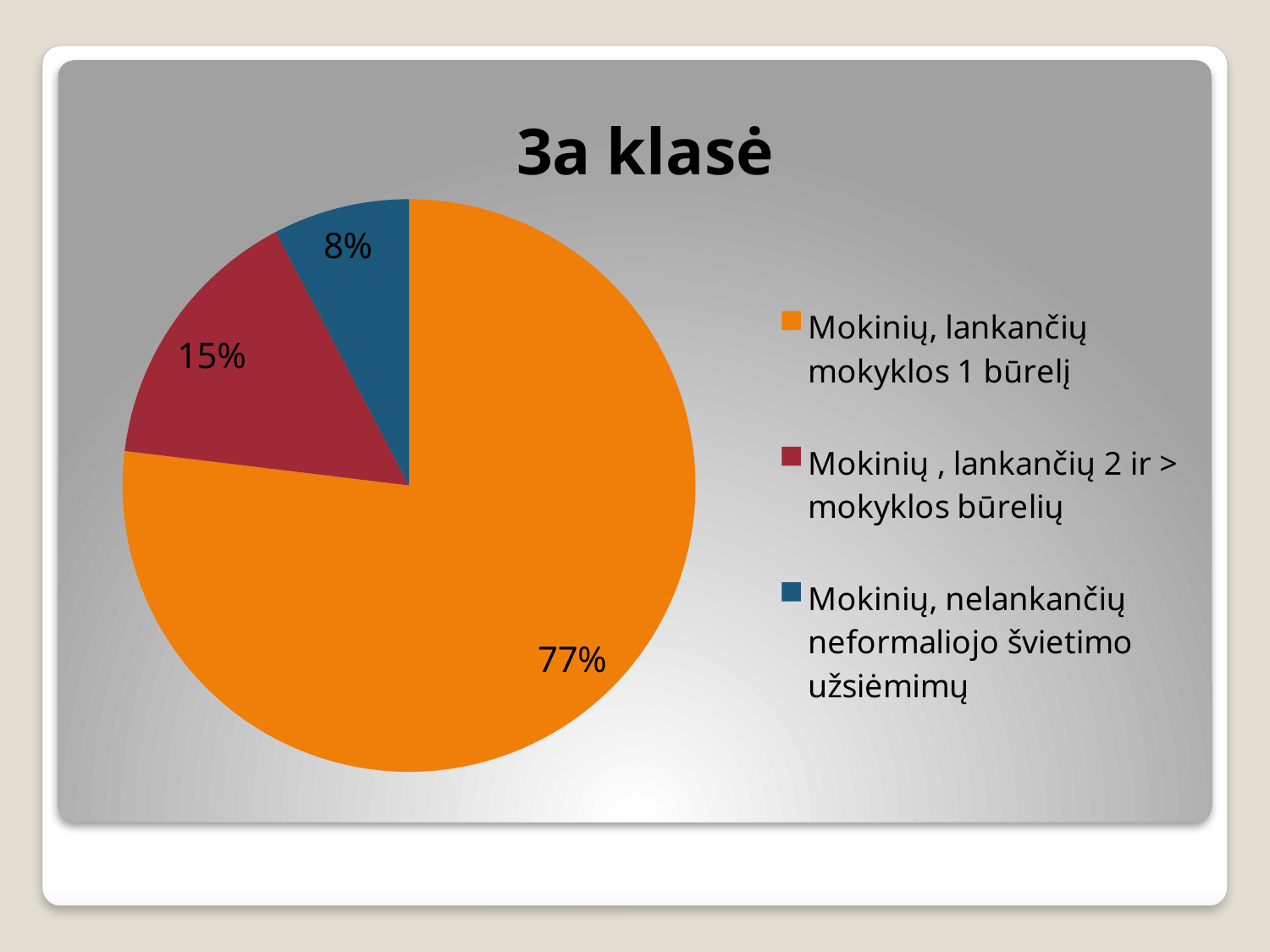
What type of chart is shown on the slide? pie chart What percentage of the pie is for 'Mokinių, lankančių mokyklos 1 būrelį'? 77% Which category has the largest slice of the pie? Mokinių, lankančių mokyklos 1 būrelį What percentage of the pie is for 'Mokinių , lankančių 2 ir > mokyklos būrelių'? 15% Which category has the smallest slice of the pie? Mokinių, nelankančių neformaliojo švietimo užsiėmimų What is the difference in percentage points between the slice for 'Mokinių, lankančių mokyklos 1 būrelį' and the slice for 'Mokinių , lankančių 2 ir > mokyklos būrelių'? 62 How many slices does the pie chart have? 3 Which is larger: the slice for 'Mokinių , lankančių 2 ir > mokyklos būrelių' or the slice for 'Mokinių, nelankančių neformaliojo švietimo užsiėmimų'? Mokinių , lankančių 2 ir > mokyklos būrelių What percentage of the pie is for 'Mokinių, nelankančių neformaliojo švietimo užsiėmimų'? 8% What colour is the slice for 'Mokinių, nelankančių neformaliojo švietimo užsiėmimų'? blue How many entries does the legend list? 3 What is the title of the chart? 3a klasė